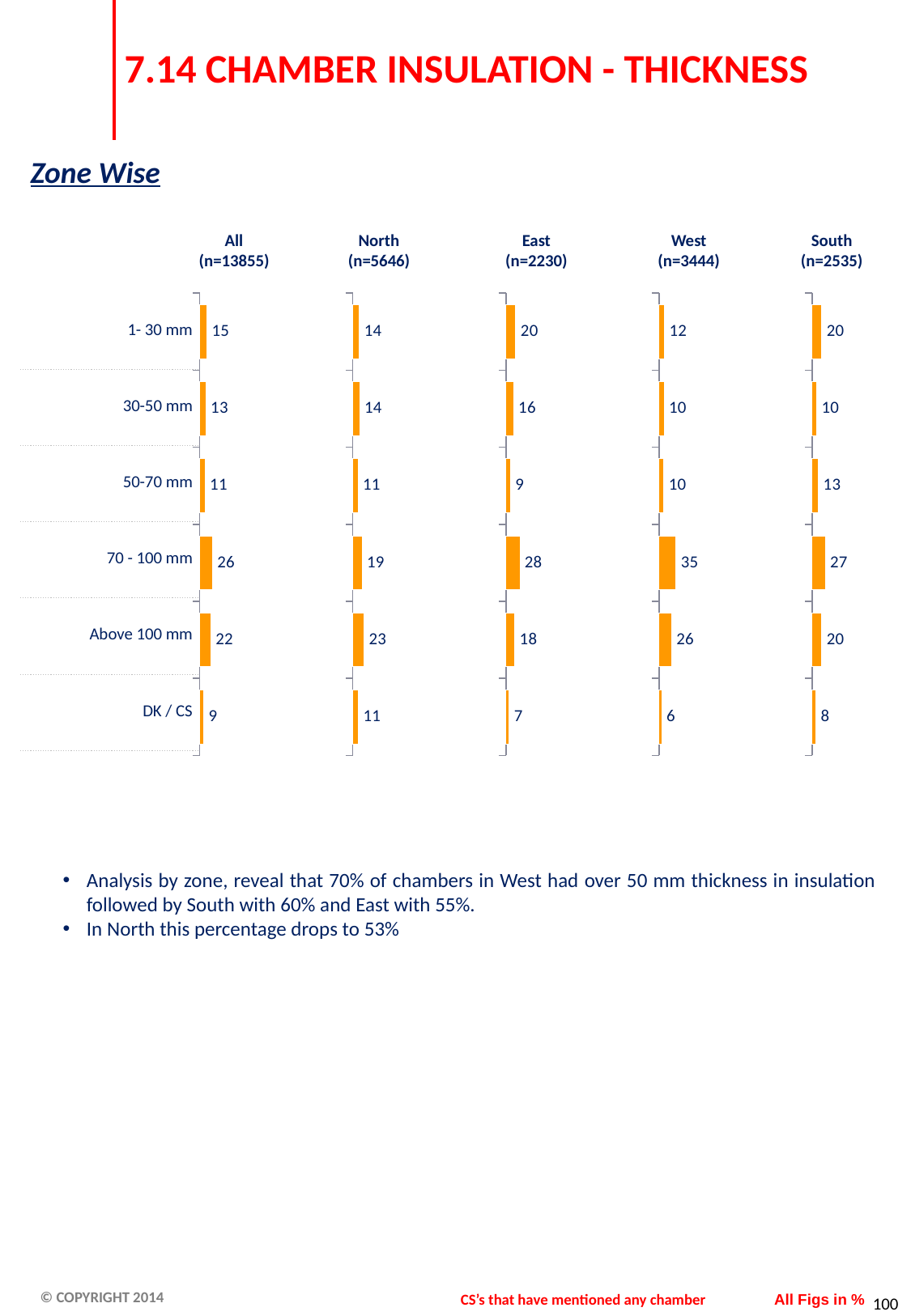
What colour are the bars in the charts? orange In the East (n=2230) chart, which is larger: the value for 1- 30 mm or the value for 30-50 mm? 1- 30 mm In the South (n=2535) chart, what is the value for 50-70 mm? 13 In the West (n=3444) chart, what is the value for 70 - 100 mm? 35 How many separate charts (zones) are shown on the slide? 5 In the North (n=5646) chart, which category has the lowest value? 50-70 mm and DK / CS (both 11) In the South (n=2535) chart, which category has the highest value? 70 - 100 mm In the West (n=3444) chart, what is the difference between the values for 70 - 100 mm and Above 100 mm? 9 What kind of chart is used for the North (n=5646) data? bar chart How many categories are shown in the All (n=13855) chart? 6 In the East (n=2230) chart, what is the value for DK / CS? 7 In the All (n=13855) chart, what is the value for Above 100 mm? 22